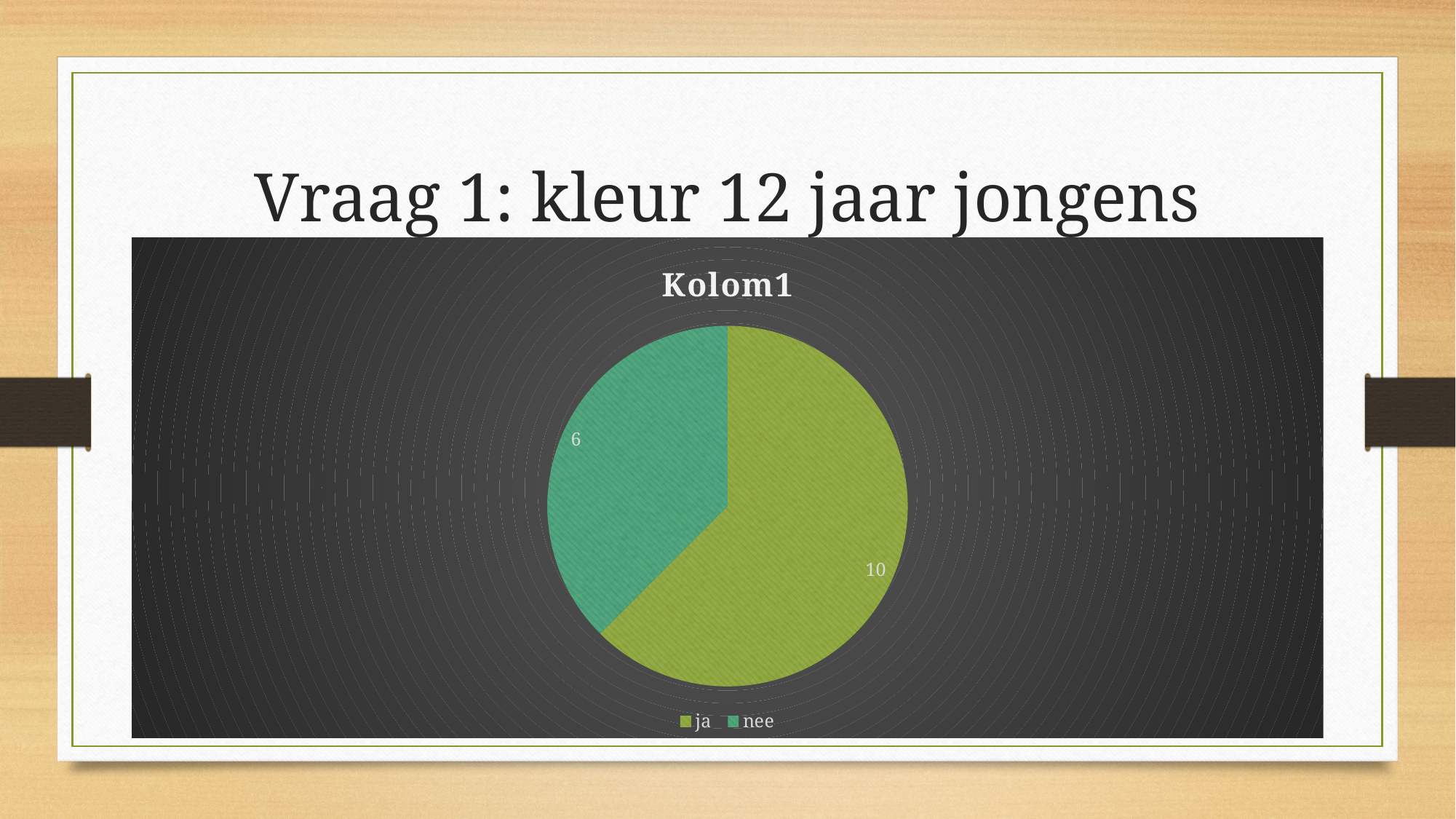
What is the title of the chart? Kolom1 What is the difference between the values for "ja" and "nee"? 4 What is the total of all slices in the pie chart? 16 Which is larger, the value for "ja" or the value for "nee"? ja Which category has the largest slice? ja Which category has the smallest slice? nee What is the value for "ja"? 10 What is the value for "nee"? 6 How many slices does the pie chart have? 2 What share of the pie does "ja" represent? 62.5% What type of chart is shown on the slide? pie chart What colour is the "nee" slice? teal